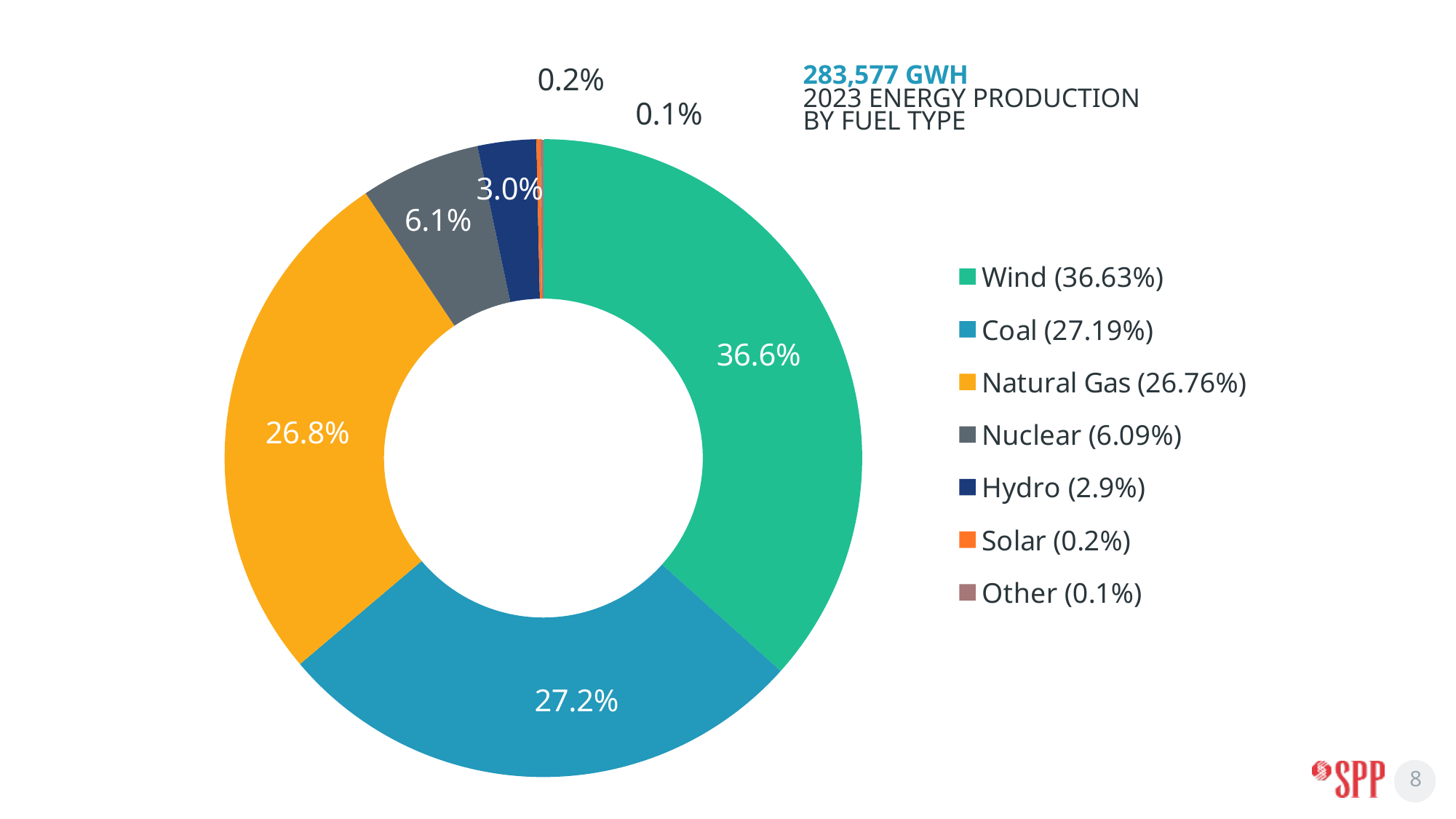
What percentage is labelled on the Coal slice of the donut chart? 27.2% Which has a larger share, Coal or Natural Gas? Coal What kind of chart is shown on the slide? Donut (pie) chart Which fuel type has the largest share of 2023 energy production? Wind By how many percentage points does the Wind slice label exceed the Coal slice label? 9.4 percentage points What percentage does the legend give for Nuclear? 6.09% How many fuel types are listed in the legend? 7 Which fuel type has the smallest share of 2023 energy production? Other What colour is the Natural Gas slice? Orange/yellow What percentage is labelled on the Natural Gas slice? 26.8% What percentage of 2023 energy production does the Wind slice show on the chart? 36.6% What total energy production figure is shown above the chart title? 283,577 GWH